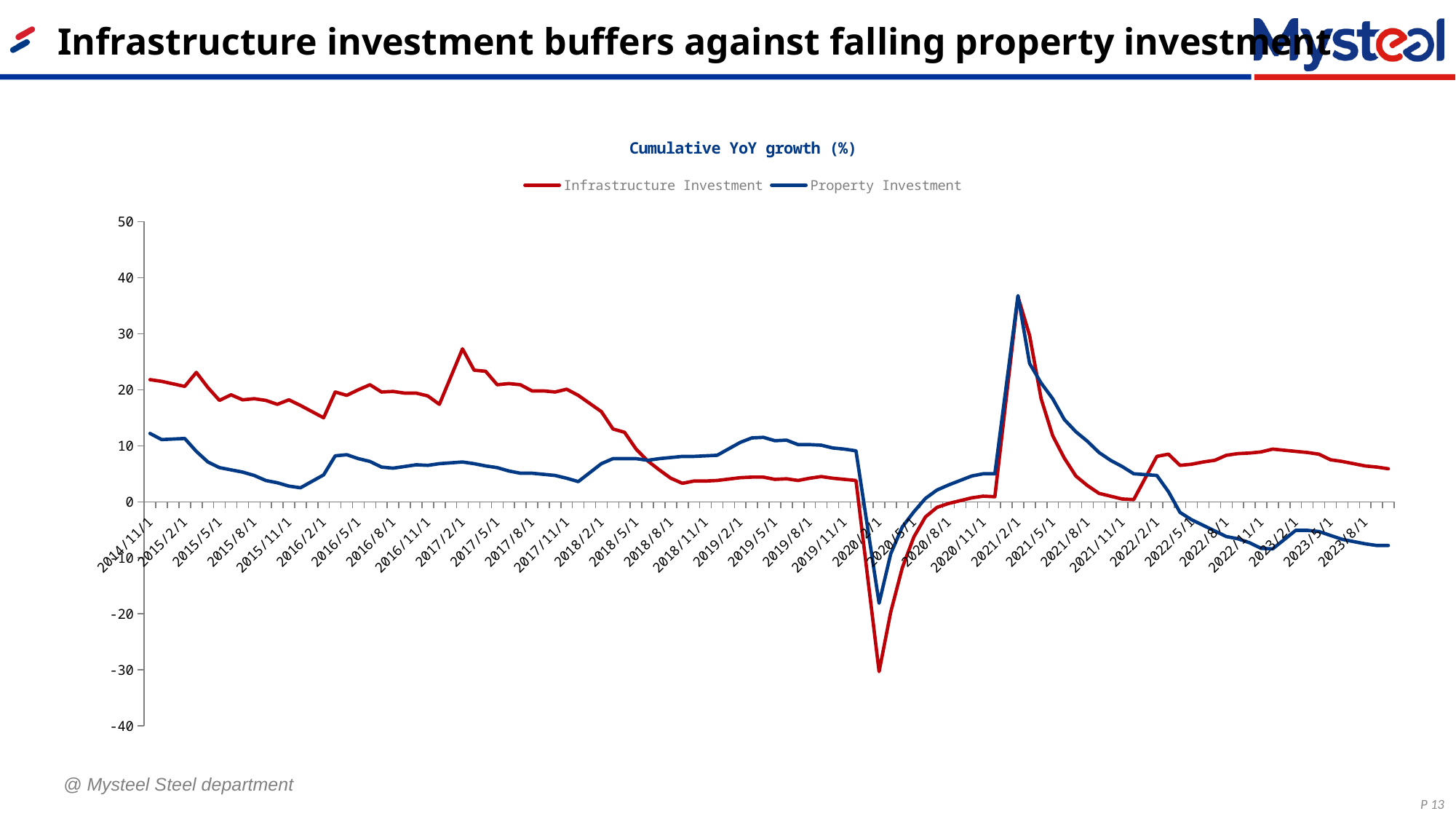
Is the Property Investment value at 2023/8/1 greater or less than 0? less At 2019/2/1, which series has the higher value, Infrastructure Investment or Property Investment? Property Investment Is the Infrastructure Investment value at 2020/2/1 greater or less than -20? less In which year does the Property Investment line reach its highest value? 2021 Which colour is used for the Property Investment line? blue How many series does the legend list? 2 Does the Property Investment line rise or fall between 2022/2/1 and 2023/8/1? fall What kind of chart is shown on the slide? line chart Is the Infrastructure Investment value at 2017/2/1 greater or less than 20? greater At 2014/11/1, which series has the higher value, Infrastructure Investment or Property Investment? Infrastructure Investment What is the title of the chart? Cumulative YoY growth (%)